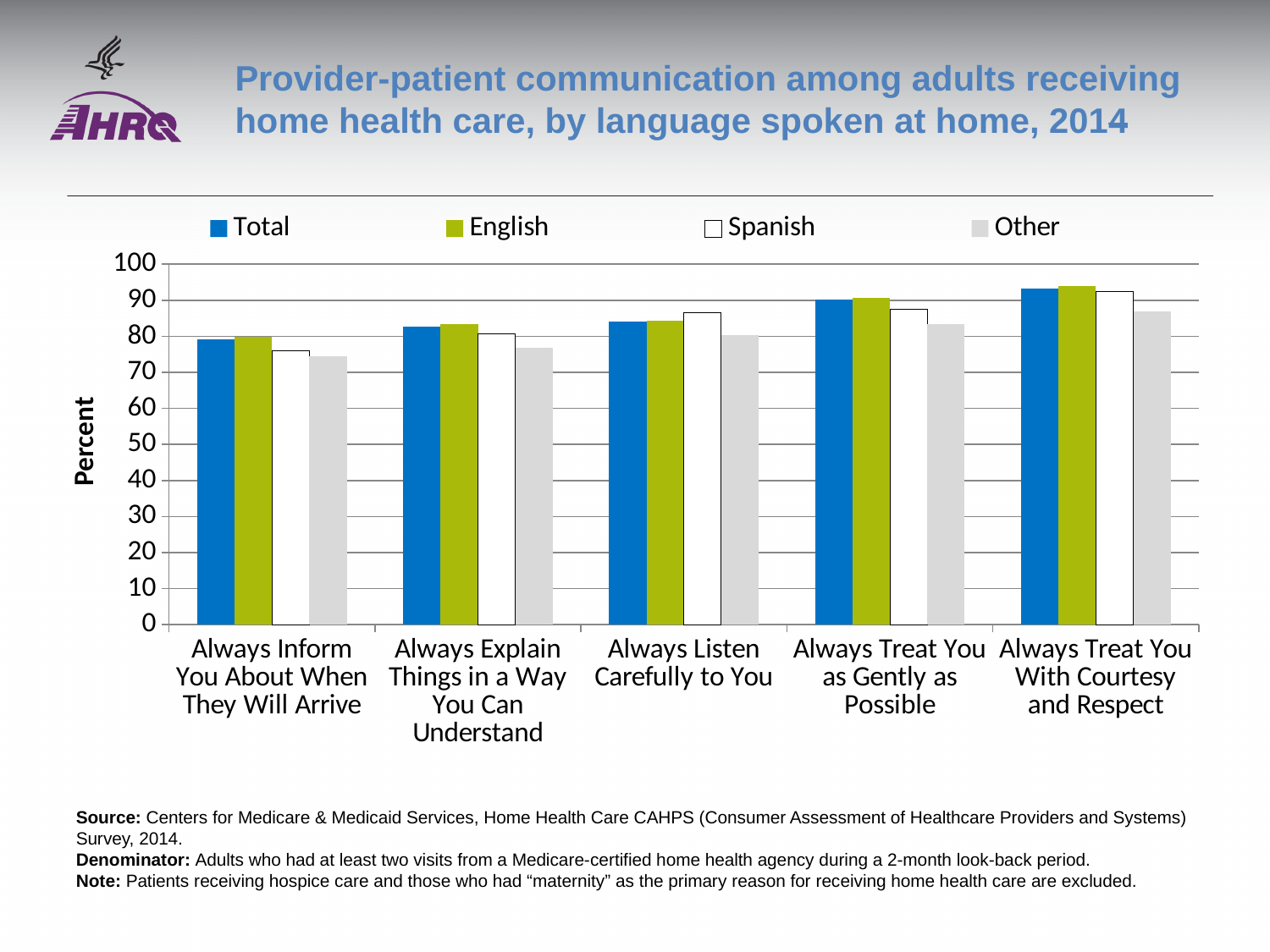
Is the value for Spanish in the "Always Listen Carefully to You" category greater or less than 80? greater Which category has the highest value for the Other series? Always Treat You With Courtesy and Respect Do the Total values rise or fall moving from left to right across the categories? Rise How many series does the legend list? 4 Is the value for Other in the "Always Inform You About When They Will Arrive" category greater or less than 80? less Is the value for Total in the "Always Treat You With Courtesy and Respect" category greater or less than 90? greater Which category has the lowest value for the Total series? Always Inform You About When They Will Arrive For the Spanish series, which is larger, the value for "Always Inform You About When They Will Arrive" or the value for "Always Explain Things in a Way You Can Understand"? Always Explain Things in a Way You Can Understand What kind of chart is shown on the slide? Bar chart How many categories are shown along the x axis? 5 In the "Always Treat You as Gently as Possible" category, which is larger, the Spanish value or the Other value? Spanish What is the label on the vertical axis? Percent